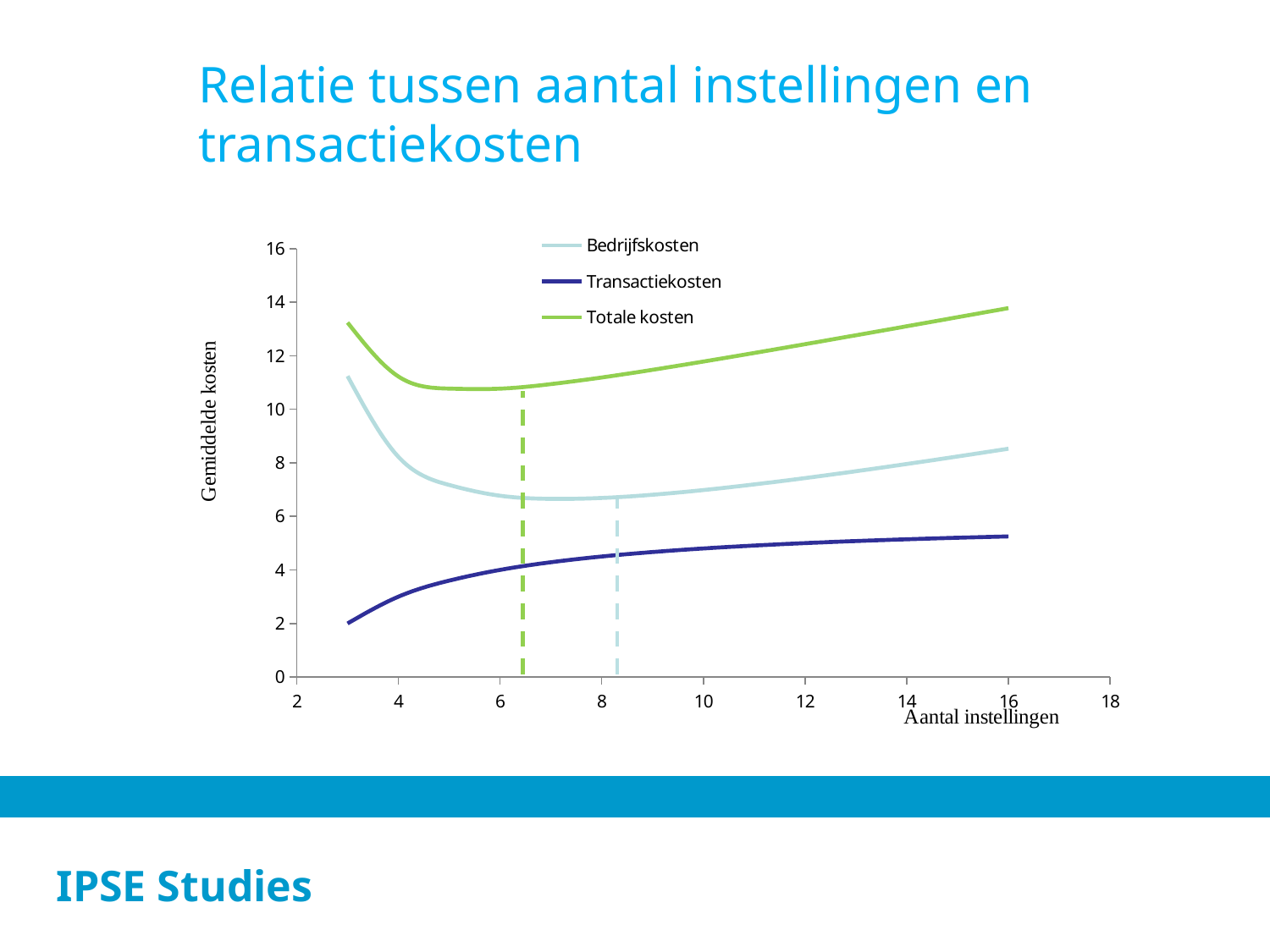
Which series are listed in the legend? Bedrijfskosten, Transactiekosten, Totale kosten Is the value of Transactiekosten at 16 institutions greater or less than 6? less Is the value of Bedrijfskosten at 3 institutions greater or less than 10? greater At 16 institutions, which is larger: Bedrijfskosten or Transactiekosten? Bedrijfskosten What is the label of the x axis? Aantal instellingen Which series has the lowest value at 4 institutions? Transactiekosten Is the value of Totale kosten at 16 institutions greater or less than 12? greater How many series does the legend list? 3 What kind of chart is shown on the slide? line chart Which series has the highest value at 10 institutions? Totale kosten Does the Transactiekosten line rise or fall as the number of institutions increases? rise